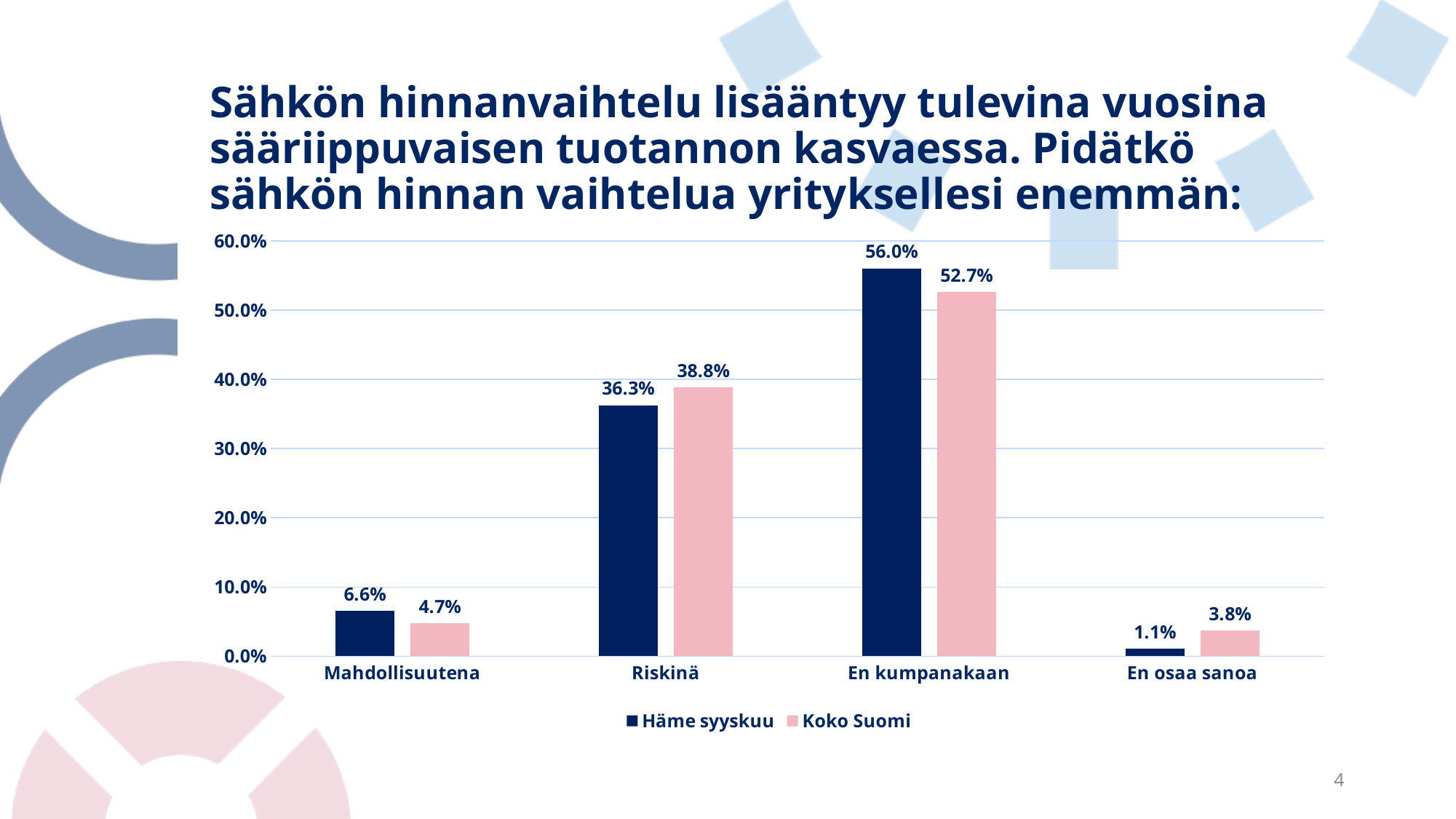
How many categories are shown on the x axis? 4 What is the difference between Häme syyskuu and Koko Suomi in the En kumpanakaan category? 3.3% Which category has the lowest value for Koko Suomi? En osaa sanoa In the Riskinä category, which series has the larger value, Häme syyskuu or Koko Suomi? Koko Suomi Is the value for Koko Suomi in the Riskinä category greater or less than 30.0%? greater What is the value for Koko Suomi in the Mahdollisuutena category? 4.7% How many series does the legend list? 2 What is the value for Koko Suomi in the En kumpanakaan category? 52.7% What kind of chart is shown on the slide? Bar chart Which category has the highest value for Häme syyskuu? En kumpanakaan What is the value for Häme syyskuu in the Riskinä category? 36.3% What is the value for Häme syyskuu in the En osaa sanoa category? 1.1%